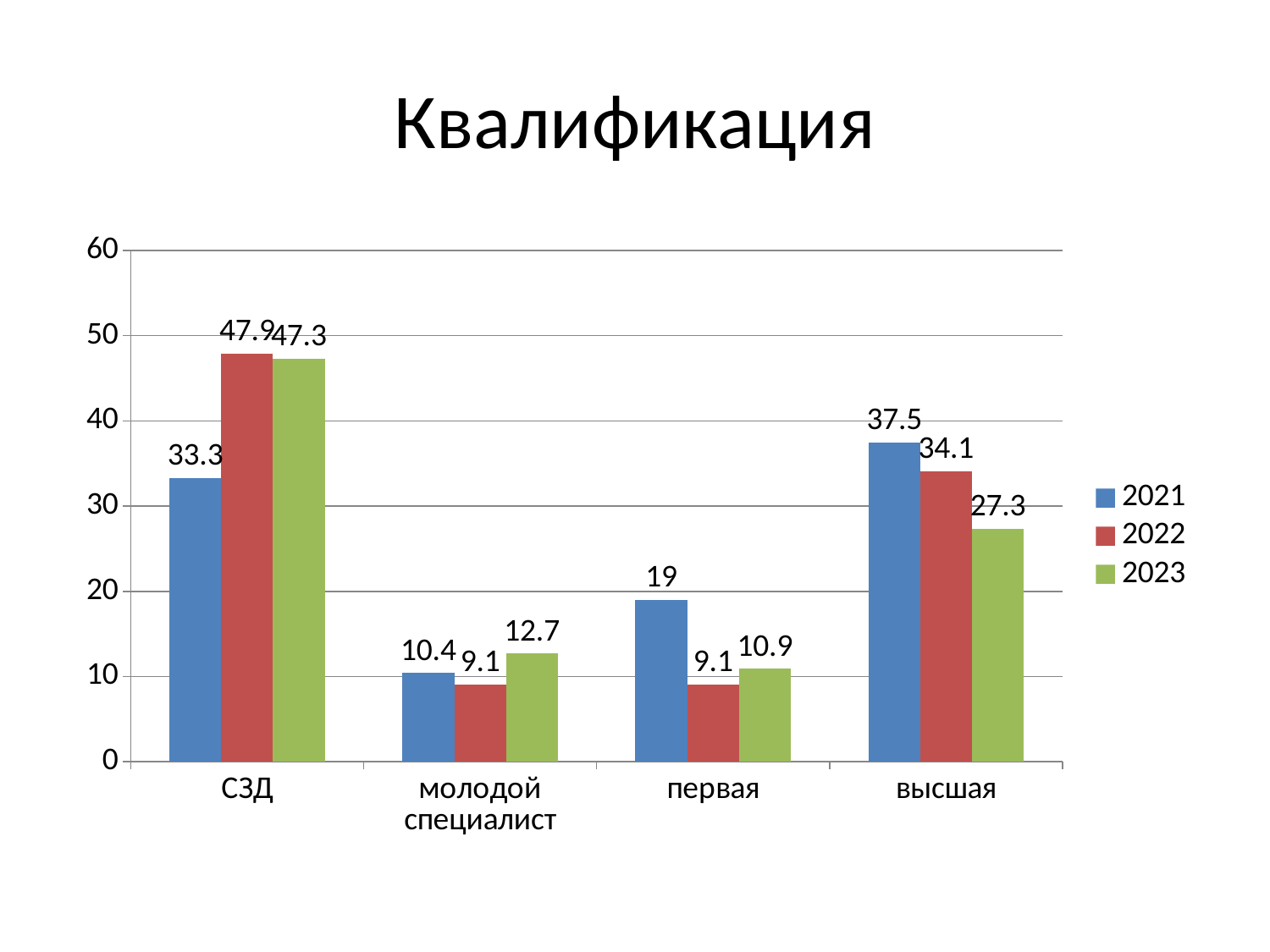
What is the title of the slide? Квалификация What kind of chart is shown on the slide? bar chart What is the value for высшая in 2023? 27.3 Which category has the lowest value in 2021? молодой специалист What is the value for СЗД in 2021? 33.3 Do the values for высшая rise or fall from 2021 to 2023? fall What is the difference between the 2021 and 2023 values for высшая? 10.2 How many series does the legend list? 3 Which is larger: the 2021 value for первая or the 2023 value for первая? 2021 value for первая Which category has the highest value in 2022? СЗД How many categories are shown on the x axis? 4 What is the value for молодой специалист in 2022? 9.1